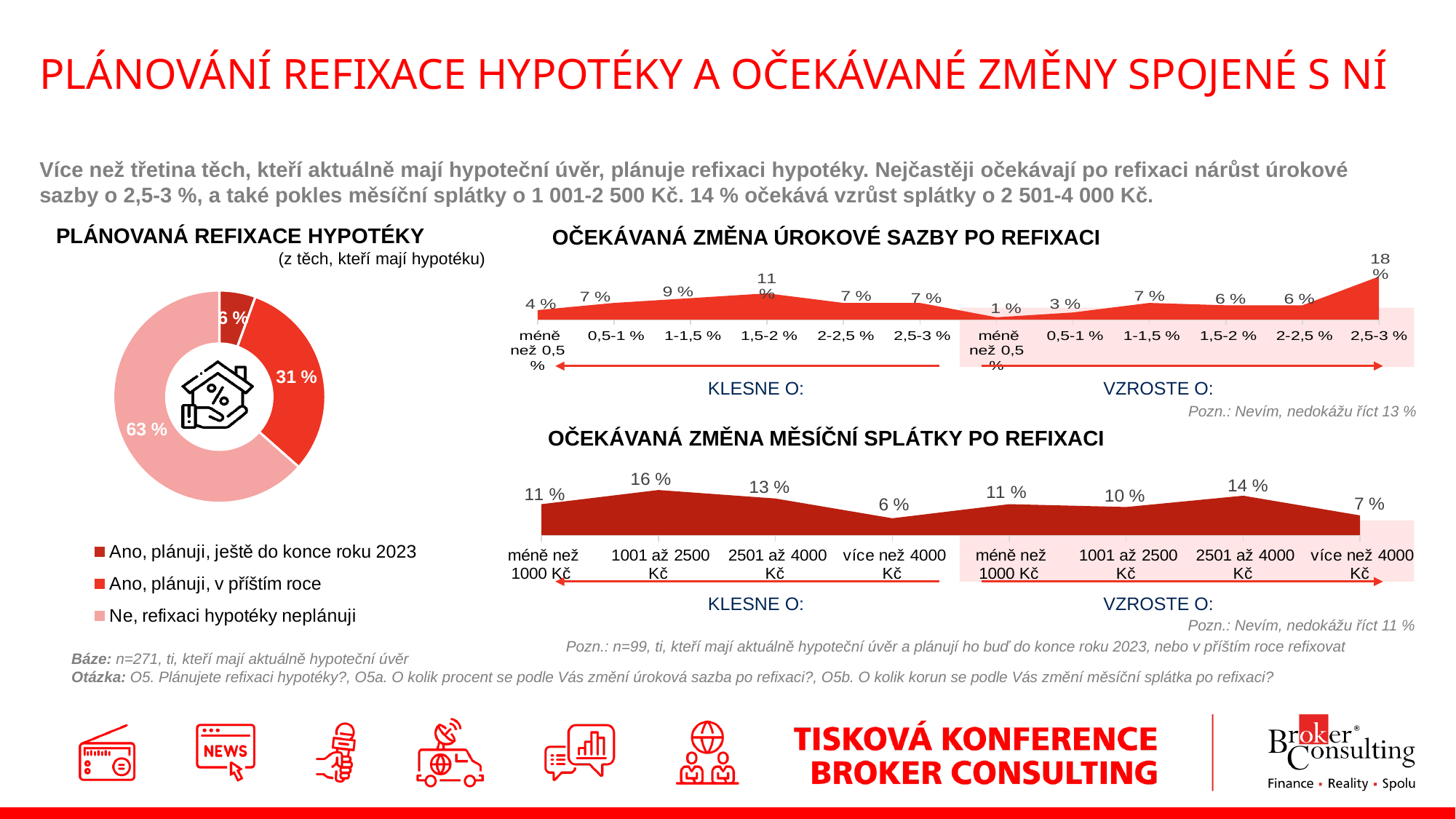
In the chart 'OČEKÁVANÁ ZMĚNA ÚROKOVÉ SAZBY PO REFIXACI', what is the difference between the 'VZROSTE O:' value for '2,5-3 %' and the 'KLESNE O:' value for '1,5-2 %'? 7 % How many categories does the legend of the donut chart 'PLÁNOVANÁ REFIXACE HYPOTÉKY' list? 3 In the chart 'OČEKÁVANÁ ZMĚNA MĚSÍČNÍ SPLÁTKY PO REFIXACI', what is the value for '1001 až 2500 Kč' in the 'KLESNE O:' section? 16 % What type of chart is 'PLÁNOVANÁ REFIXACE HYPOTÉKY'? Donut (pie) chart In the chart 'OČEKÁVANÁ ZMĚNA ÚROKOVÉ SAZBY PO REFIXACI', what is the value for '2,5-3 %' in the 'VZROSTE O:' section? 18 % In the chart 'OČEKÁVANÁ ZMĚNA ÚROKOVÉ SAZBY PO REFIXACI', what is the lowest value shown in the 'VZROSTE O:' section? 1 % In the chart 'OČEKÁVANÁ ZMĚNA MĚSÍČNÍ SPLÁTKY PO REFIXACI', which is larger: the 'VZROSTE O:' value for '2501 až 4000 Kč' or the 'VZROSTE O:' value for '1001 až 2500 Kč'? 2501 až 4000 Kč In the chart 'OČEKÁVANÁ ZMĚNA MĚSÍČNÍ SPLÁTKY PO REFIXACI', what is the difference between the 'KLESNE O:' values for '1001 až 2500 Kč' and 'více než 4000 Kč'? 10 % In the donut chart 'PLÁNOVANÁ REFIXACE HYPOTÉKY', what share corresponds to 'Ano, plánuji, v příštím roce'? 31 % In the donut chart 'PLÁNOVANÁ REFIXACE HYPOTÉKY', which category has the smallest share? Ano, plánuji, ještě do konce roku 2023 In the chart 'OČEKÁVANÁ ZMĚNA ÚROKOVÉ SAZBY PO REFIXACI', which category in the 'KLESNE O:' section has the highest value? 1,5-2 % In the donut chart 'PLÁNOVANÁ REFIXACE HYPOTÉKY', what share corresponds to 'Ne, refixaci hypotéky neplánuji'? 63 %